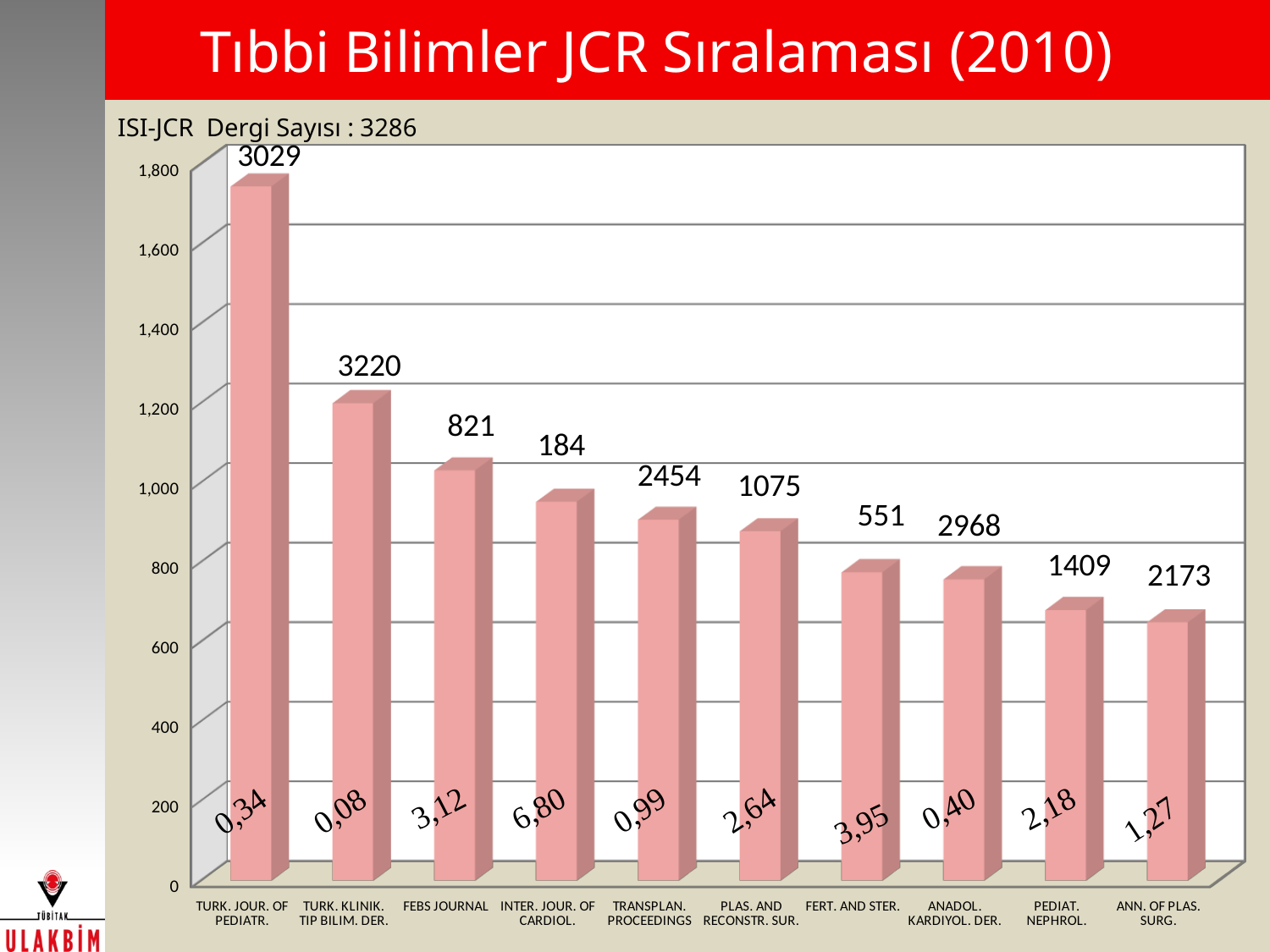
What kind of chart is shown on the slide? bar chart Is the bar for TURK. JOUR. OF PEDIATR. greater or less than 1,600? greater What is the title of the chart slide? Tıbbi Bilimler JCR Sıralaması (2010) Is the bar for FEBS JOURNAL greater or less than 800? greater Do the bar heights rise or fall from left to right along the x axis? fall Which journal has the tallest bar? TURK. JOUR. OF PEDIATR. What number is printed above the bar for FEBS JOURNAL? 821 Which journal has the shortest bar? ANN. OF PLAS. SURG. Which bar is taller, TRANSPLAN. PROCEEDINGS or FERT. AND STER.? TRANSPLAN. PROCEEDINGS Is the bar for PEDIAT. NEPHROL. greater or less than 800? less How many journals (categories) are shown on the x axis? 10